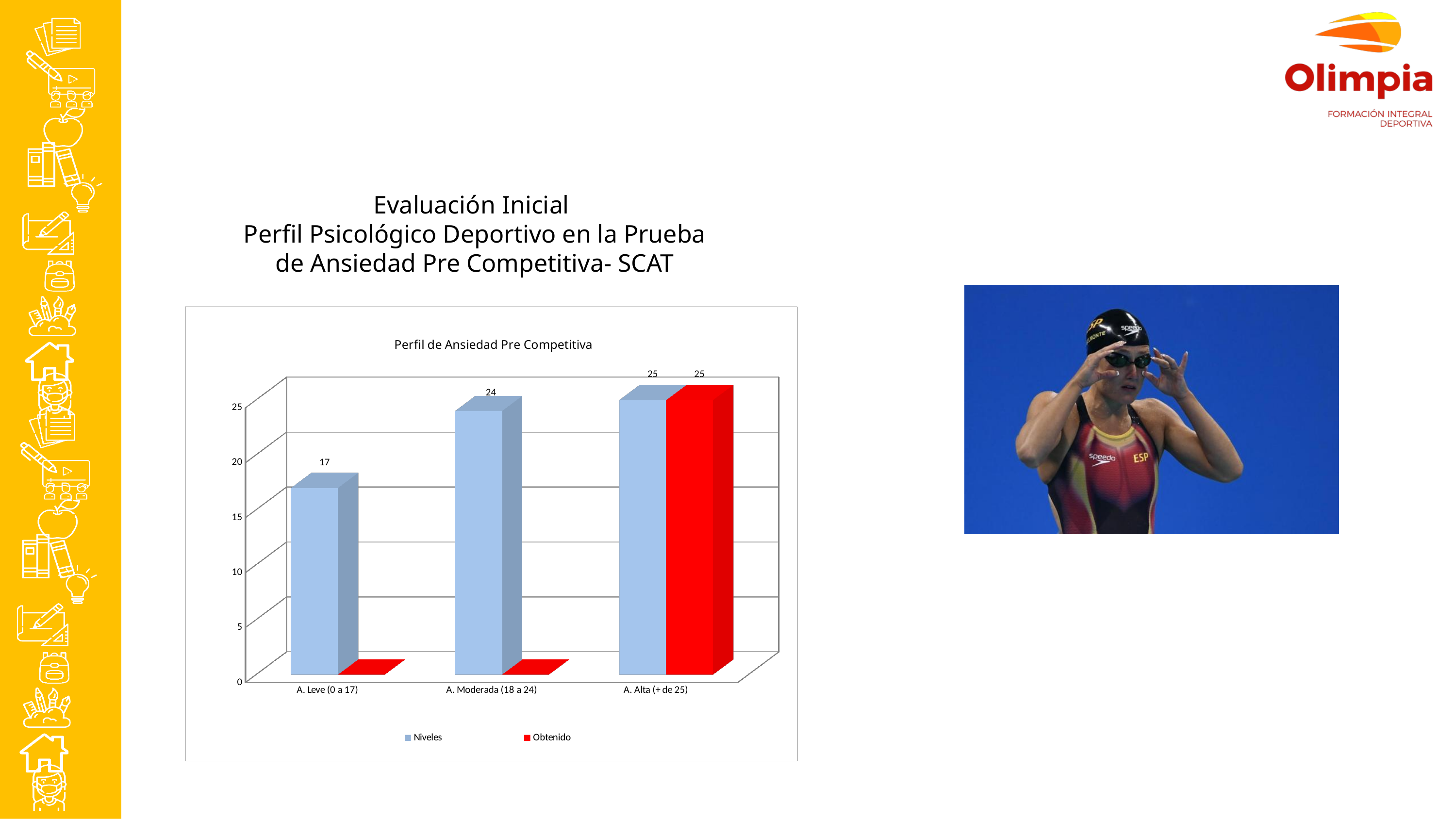
How many series does the chart legend list? 2 What is the difference between the Niveles values for A. Moderada (18 a 24) and A. Leve (0 a 17)? 7 What is the value of the Niveles series for A. Moderada (18 a 24)? 24 What kind of chart is shown on the slide? bar chart What is the value of the Obtenido series for A. Alta (+ de 25)? 25 Is the Obtenido value for A. Leve (0 a 17) greater or less than 5? less What is the title of the chart? Perfil de Ansiedad Pre Competitiva Which category has the highest Obtenido value? A. Alta (+ de 25) What is the value of the Niveles series for A. Leve (0 a 17)? 17 Which is larger: the Niveles value for A. Alta (+ de 25) or the Niveles value for A. Leve (0 a 17)? A. Alta (+ de 25) Which category has the lowest Niveles value? A. Leve (0 a 17) How many categories are shown on the x axis of the chart? 3